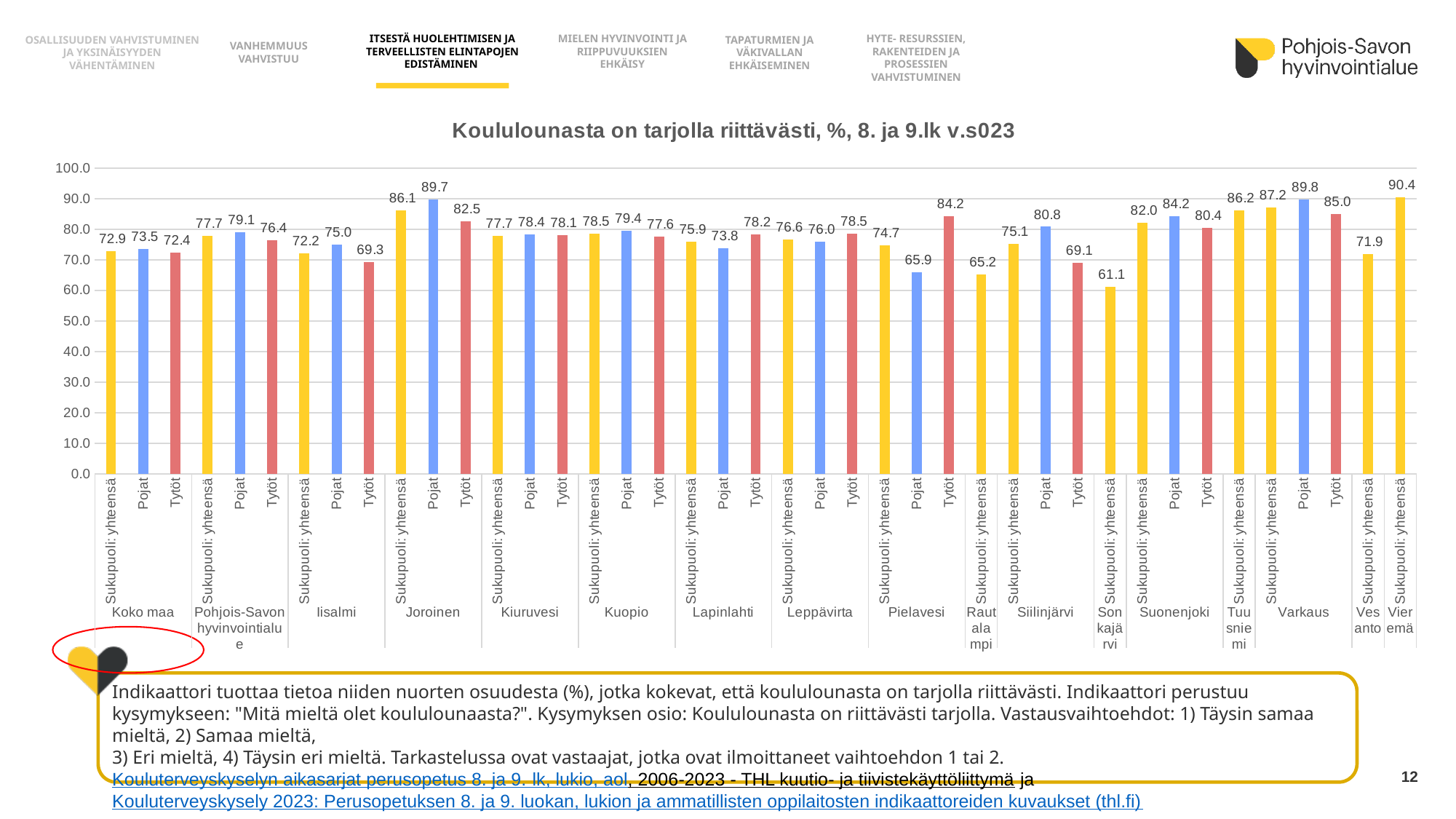
What is the value for Tytöt in Pielavesi? 84.2 Is the value for Sukupuoli: yhteensä in Rautalampi greater or less than 70.0? less Which group has the lowest bar on the chart? Sonkajärvi (Sukupuoli: yhteensä) How many municipalities or areas are shown along the x axis? 17 Which group has the highest bar on the chart? Vieremä (Sukupuoli: yhteensä) What is the value for Sukupuoli: yhteensä in Koko maa? 72.9 What is the value for Pojat in Joroinen? 89.7 What kind of chart is shown on the slide? Bar chart Which is larger in Pielavesi, the value for Pojat or the value for Tytöt? Tytöt What is the title of the chart? Koululounasta on tarjolla riittävästi, %, 8. ja 9.lk v.s023 What is the value for Sukupuoli: yhteensä in Vieremä? 90.4 What is the difference between Pojat and Tytöt in Siilinjärvi? 11.7